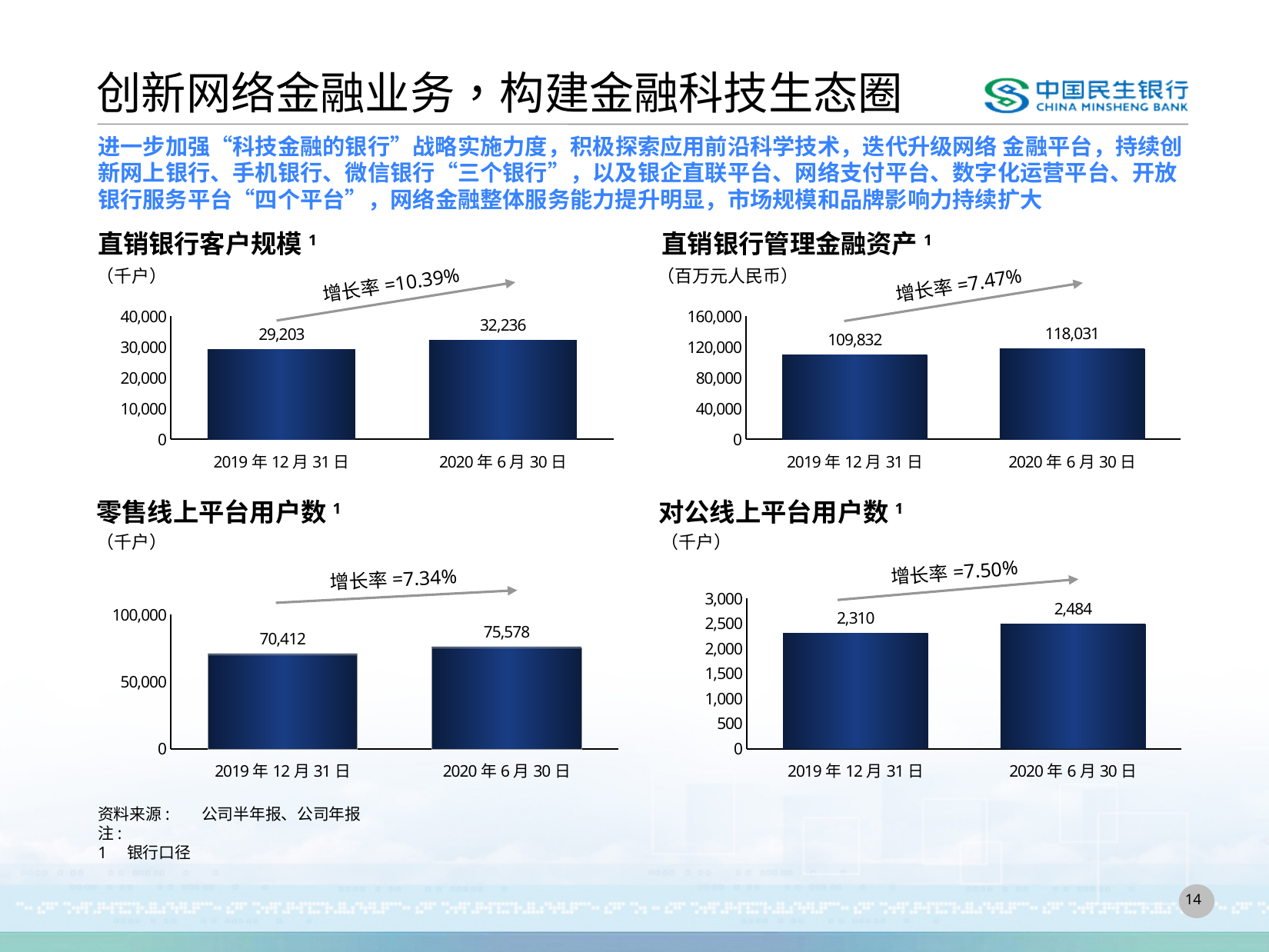
In the chart titled 直销银行客户规模, is the value for 2019 年 12 月 31 日 greater or less than 30,000? less How many categories are shown on the x axis of the chart titled 直销银行管理金融资产? 2 In the chart titled 直销银行管理金融资产, by how much does the 2020 年 6 月 30 日 value exceed the 2019 年 12 月 31 日 value? 8,199 In the chart titled 直销银行管理金融资产, what is the value for 2019 年 12 月 31 日? 109,832 In the chart titled 直销银行客户规模, what is the difference between the 2020 年 6 月 30 日 value and the 2019 年 12 月 31 日 value? 3,033 In the chart titled 对公线上平台用户数, what is the difference between the two bars? 174 In the chart titled 对公线上平台用户数, what is the value for 2019 年 12 月 31 日? 2,310 What type of chart is the chart titled 对公线上平台用户数? bar chart In the chart titled 直销银行客户规模, what is the value for 2020 年 6 月 30 日? 32,236 In the chart titled 零售线上平台用户数, what is the value for 2020 年 6 月 30 日? 75,578 In the chart titled 零售线上平台用户数, which date has the higher value? 2020 年 6 月 30 日 What growth rate (增长率) is annotated on the chart titled 零售线上平台用户数? 7.34%